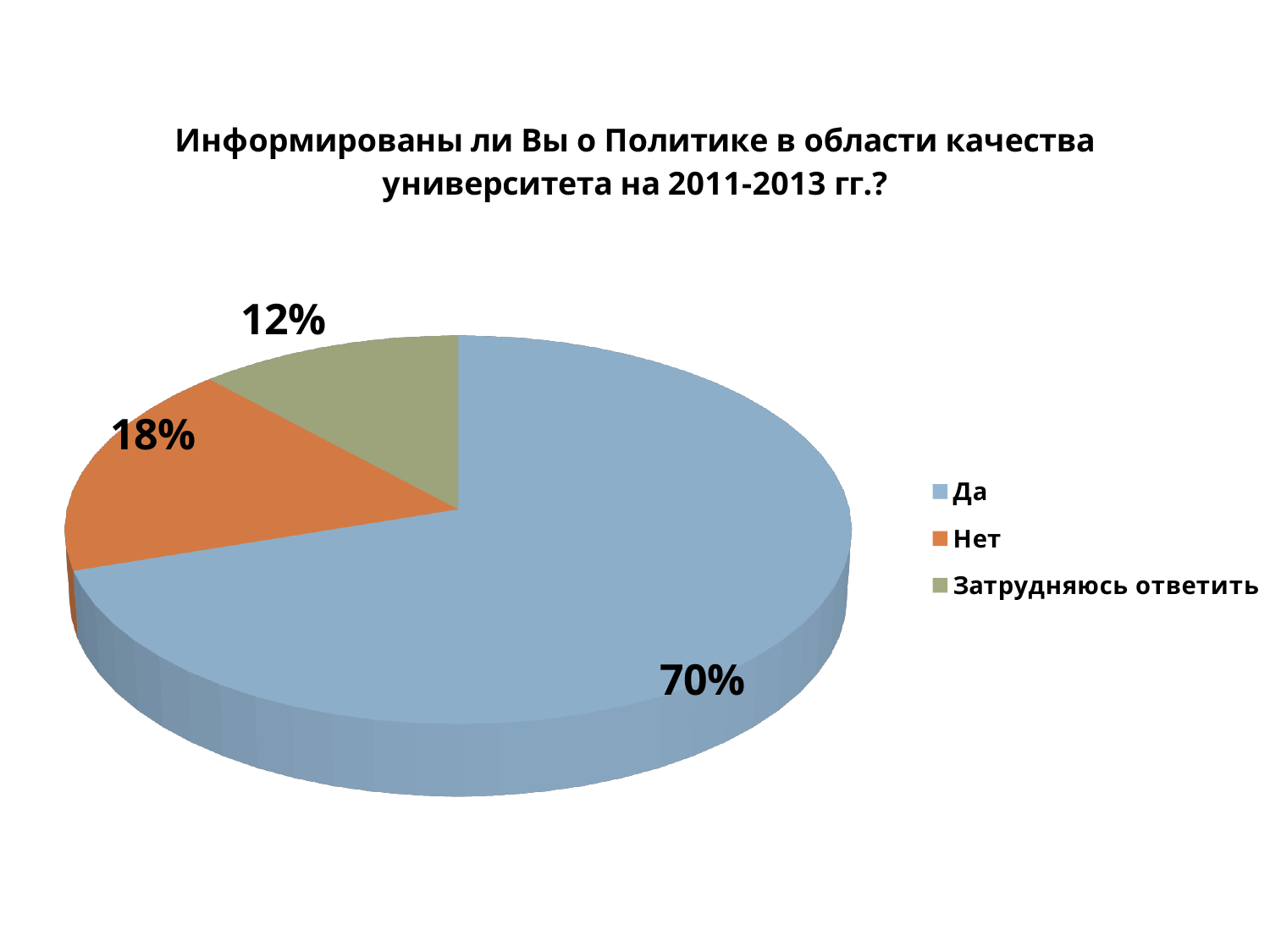
How many entries does the legend list? 3 What is the difference in percentage points between the "Да" and "Нет" slices? 52 What share of the pie is labelled "Да"? 70% Which slice is larger, "Нет" or "Затрудняюсь ответить"? Нет What share of the pie is labelled "Нет"? 18% How many slices does the pie chart have? 3 What kind of chart is shown on the slide? Pie chart What share of the pie is labelled "Затрудняюсь ответить"? 12% Which category has the largest slice of the pie? Да What colour is the "Нет" slice? Orange What is the difference in percentage points between the "Нет" and "Затрудняюсь ответить" slices? 6 Which category has the smallest slice of the pie? Затрудняюсь ответить